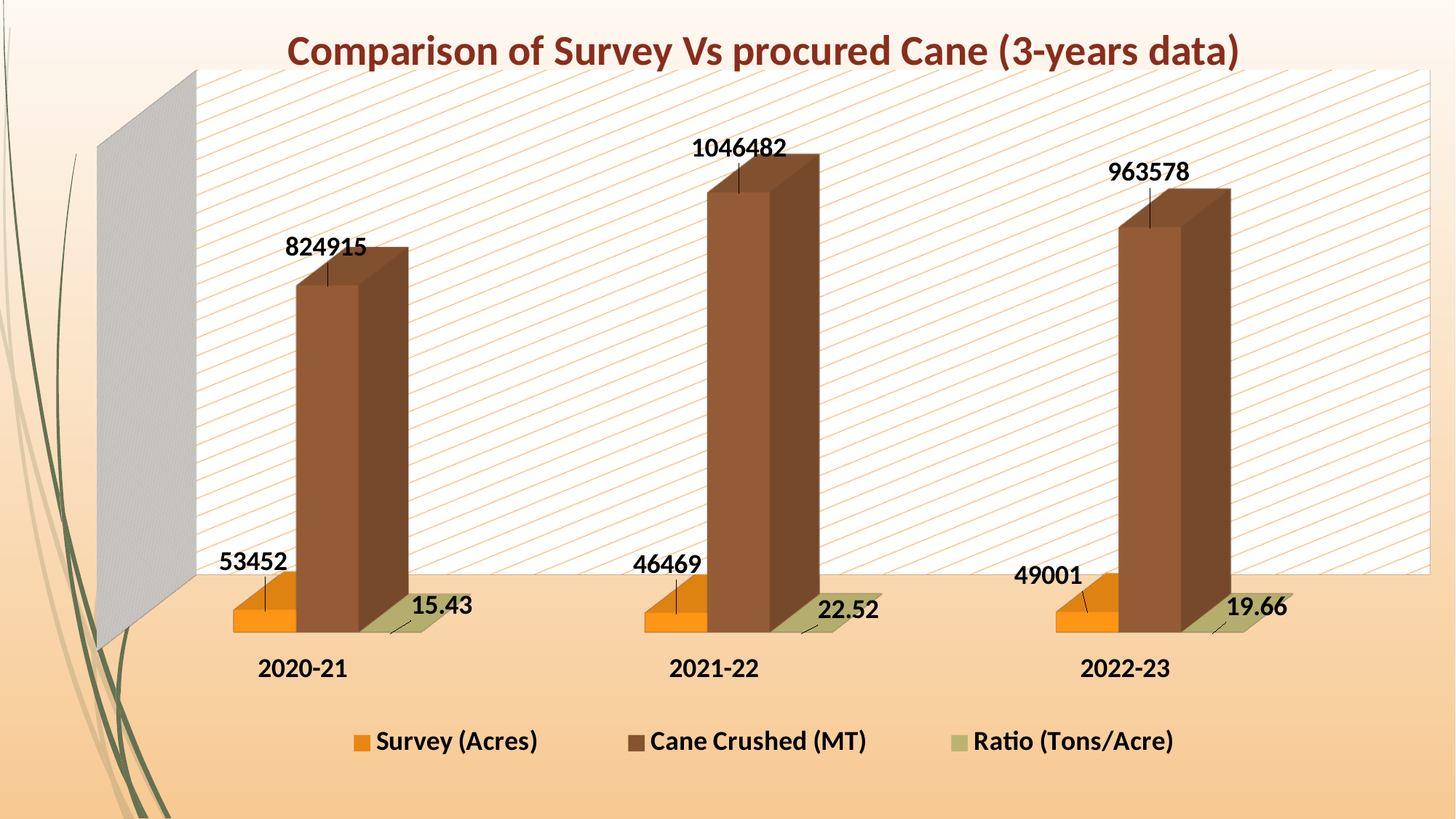
Does the Ratio (Tons/Acre) rise or fall from 2021-22 to 2022-23? Fall How many years are shown on the x axis? 3 Which year has the lowest Survey (Acres) value? 2021-22 Which is larger, the Survey (Acres) value for 2020-21 or for 2022-23? 2020-21 What is the title of the chart? Comparison of Survey Vs procured Cane (3-years data) What is the Cane Crushed (MT) value for 2021-22? 1046482 What is the Survey (Acres) value for 2020-21? 53452 How many series does the legend list? 3 Which year has the highest Cane Crushed (MT) value? 2021-22 What is the difference in Cane Crushed (MT) between 2021-22 and 2020-21? 221567 What is the Ratio (Tons/Acre) for 2022-23? 19.66 What kind of chart is shown on the slide? Bar chart